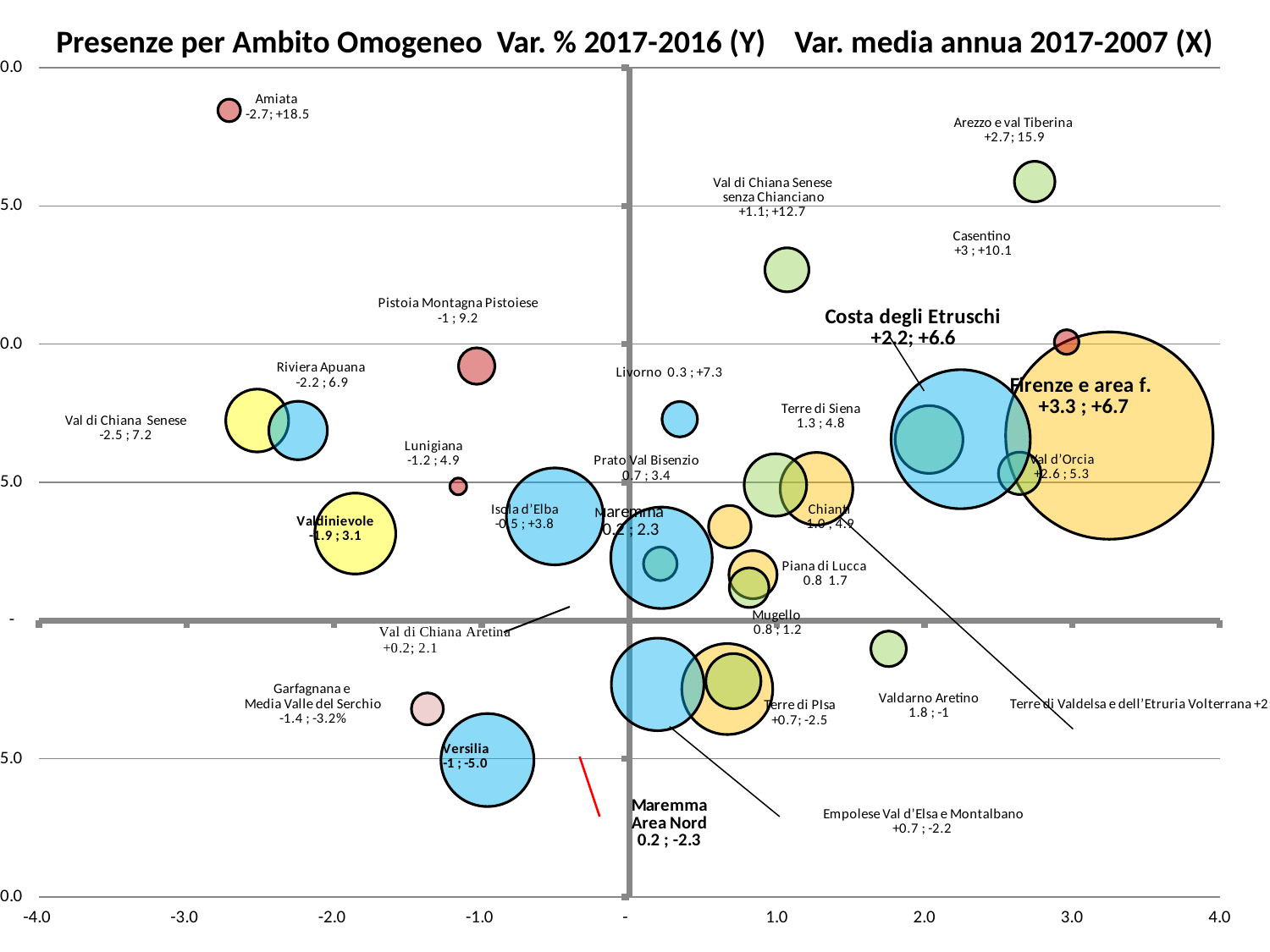
What are the X and Y values printed for Amiata? -2.7; +18.5 Which ambito has the highest X value (Var. media annua 2017-2007)? Firenze e area f. Which ambito has the highest Y value (Var. % 2017-2016)? Amiata Which ambito has the lowest Y value (Var. % 2017-2016)? Versilia Which has a higher Y value, Arezzo e val Tiberina or Casentino? Arezzo e val Tiberina What are the X and Y values printed for Firenze e area f.? +3.3 ; +6.7 What are the X and Y values printed for Costa degli Etruschi? +2.2; +6.6 What are the X and Y values printed for Casentino? +3 ; +10.1 What is the title of the chart? Presenze per Ambito Omogeneo Var. % 2017-2016 (Y) Var. media annua 2017-2007 (X) What is the difference between the Y values of Amiata (+18.5) and Arezzo e val Tiberina (15.9)? 2.6 What are the X and Y values printed for Versilia? -1 ; -5.0 What kind of chart is shown on the slide? bubble chart